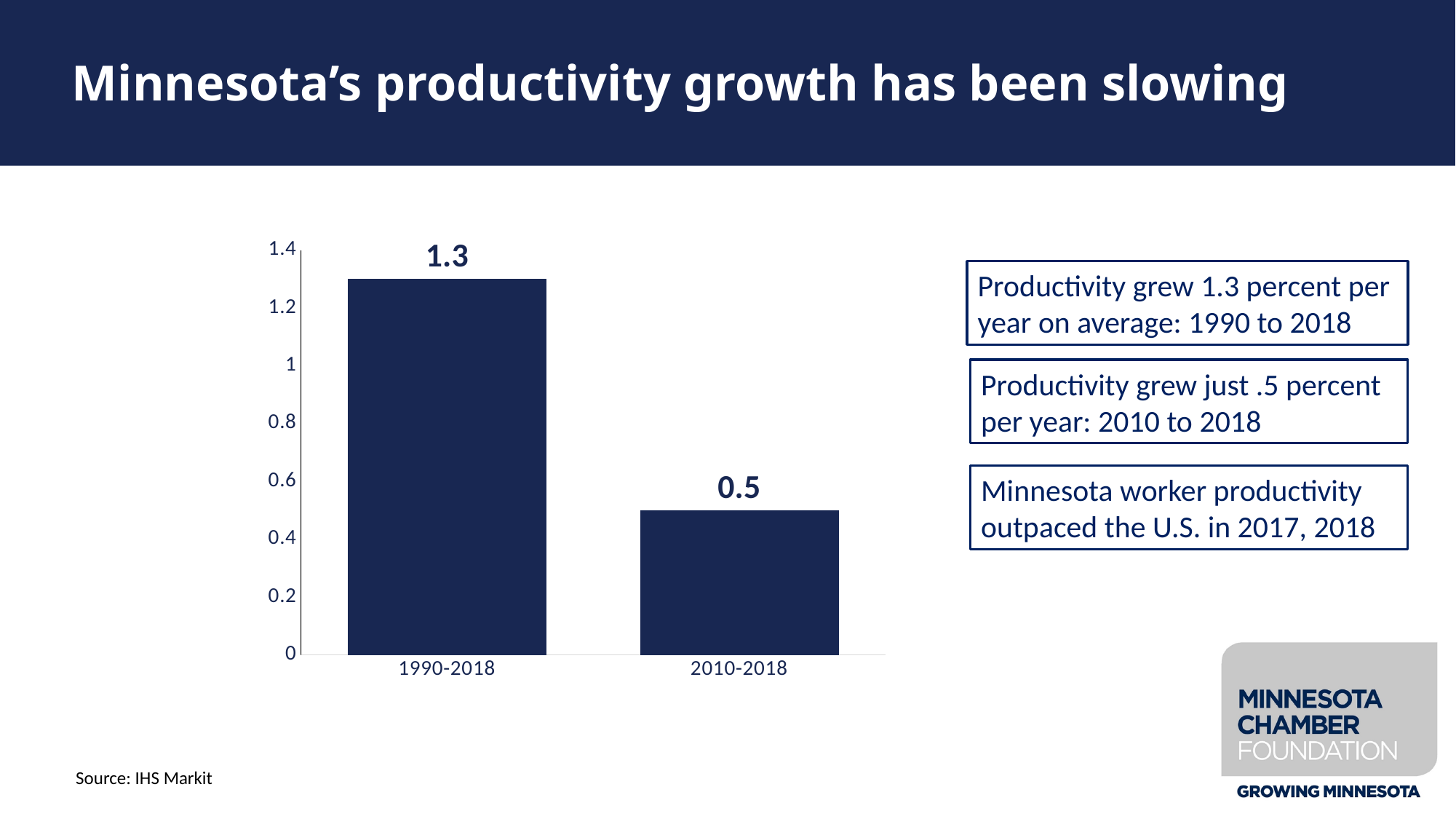
What kind of chart is shown on the slide? bar chart Is the value for 2010-2018 greater or less than 1? less Which period has the highest value? 1990-2018 What is the value for 1990-2018? 1.3 Is the value for 1990-2018 greater or less than 1.2? greater Which is larger, the value for 1990-2018 or the value for 2010-2018? 1990-2018 Which period has the lowest value? 2010-2018 How many categories are shown on the x axis? 2 What is the value for 2010-2018? 0.5 What is the difference between the values for 1990-2018 and 2010-2018? 0.8 What is the highest value shown on the y axis? 1.4 Do the values rise or fall from 1990-2018 to 2010-2018? fall